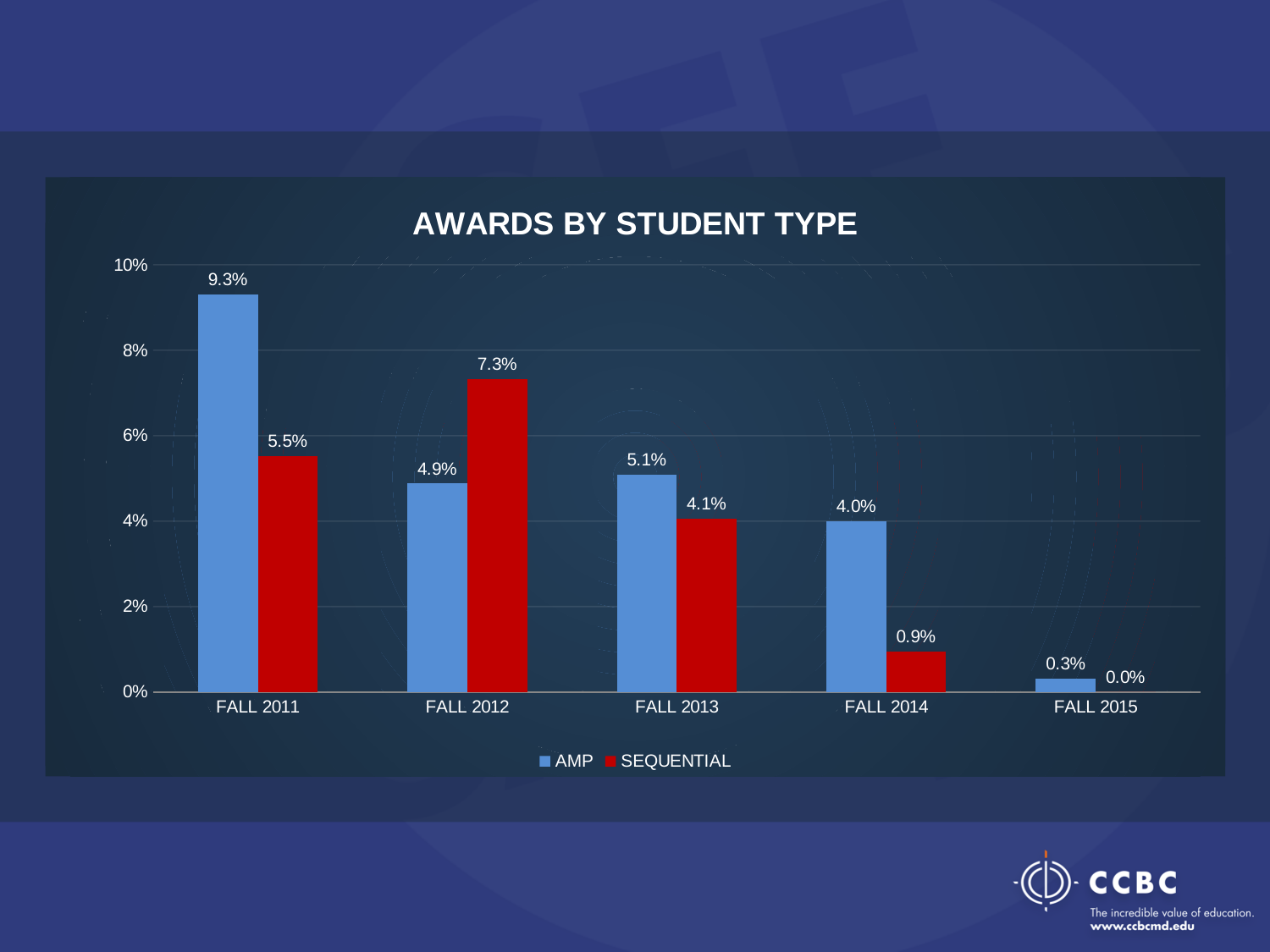
What kind of chart is shown? Bar chart What is the title of the chart? AWARDS BY STUDENT TYPE What is the AMP value for FALL 2011? 9.3% What is the SEQUENTIAL value for FALL 2012? 7.3% What is the SEQUENTIAL value for FALL 2014? 0.9% Which is larger for FALL 2012, the AMP value or the SEQUENTIAL value? SEQUENTIAL Which term has the lowest SEQUENTIAL value? FALL 2015 What is the AMP value for FALL 2015? 0.3% How many series does the legend list? 2 What is the difference between the AMP and SEQUENTIAL values for FALL 2011? 3.8% Which term has the highest AMP value? FALL 2011 How many terms are shown on the x axis? 5